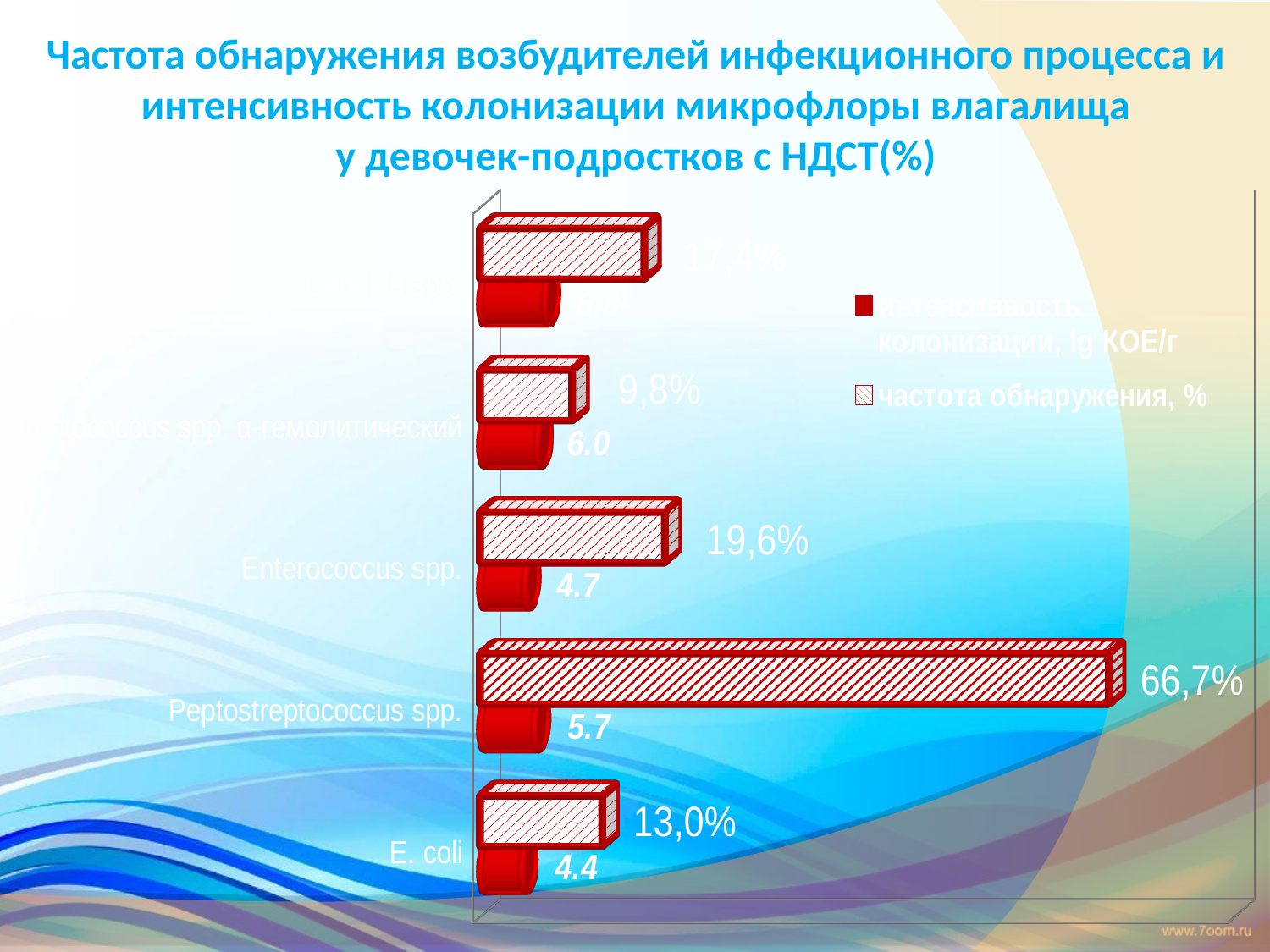
How many data series does the legend list? 2 Which has a higher detection frequency, Enterococcus spp. or E. coli? Enterococcus spp. What is the colonization intensity (интенсивность колонизации, lg КОЕ/г) for Enterococcus spp.? 4.7 What is the difference in detection frequency between Peptostreptococcus spp. and Enterococcus spp.? 47,1% What is the colonization intensity (интенсивность колонизации, lg КОЕ/г) for Peptostreptococcus spp.? 5.7 What is the colonization intensity (интенсивность колонизации, lg КОЕ/г) for E. coli? 4.4 What is the detection frequency (частота обнаружения, %) for Peptostreptococcus spp.? 66,7% What is the detection frequency (частота обнаружения, %) for E. coli? 13,0% What type of chart is shown on the slide? Bar chart Which microorganism has the highest detection frequency? Peptostreptococcus spp. What is the difference in colonization intensity between Peptostreptococcus spp. and E. coli? 1.3 What is the detection frequency (частота обнаружения, %) for Enterococcus spp.? 19,6%